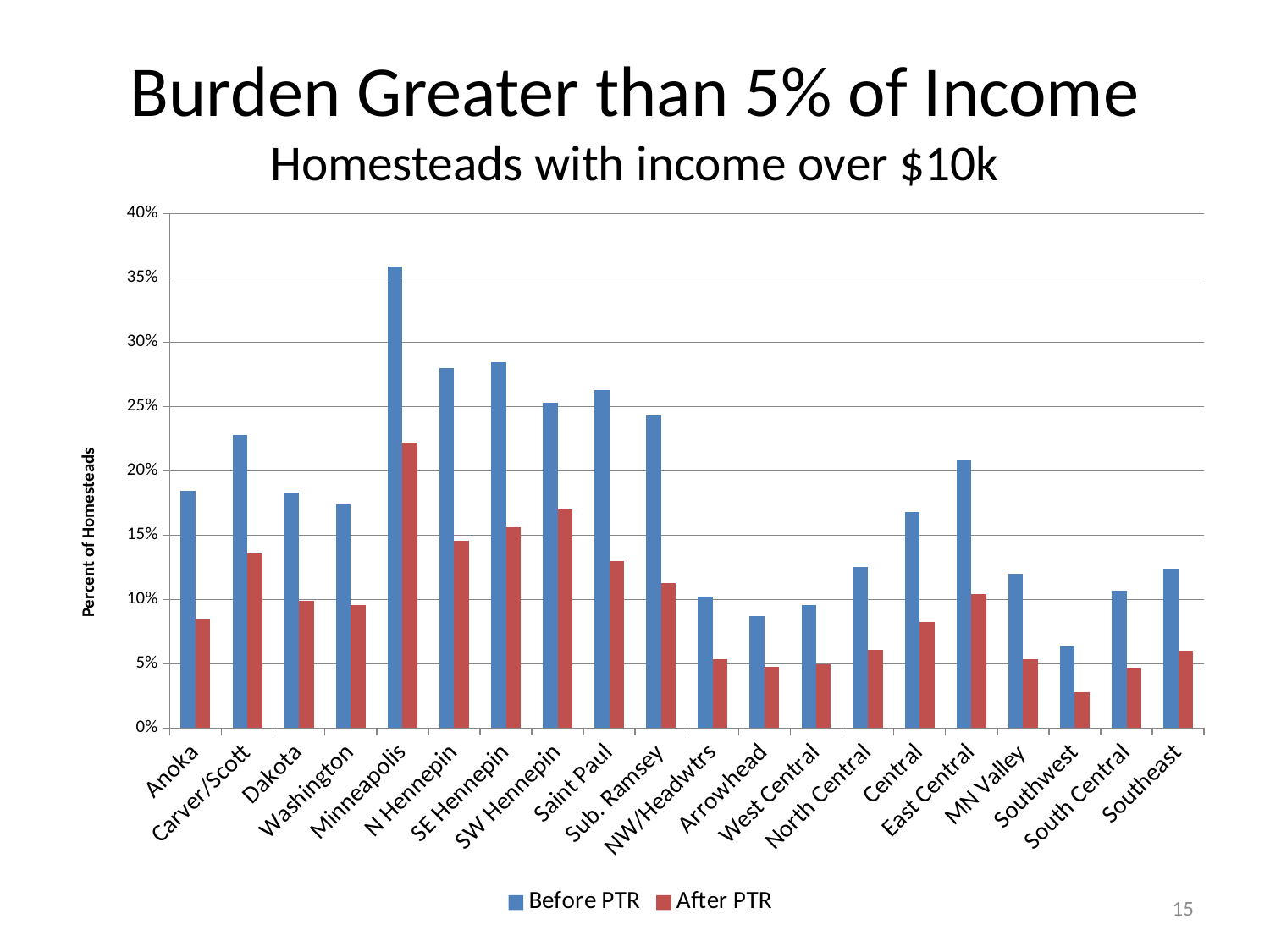
Is the After PTR value for Carver/Scott greater or less than 10%? greater Which region has the lowest Before PTR value? Southwest Which region has the highest After PTR value? Minneapolis How many series does the legend list? 2 Which region has the lowest After PTR value? Southwest What is the label on the y axis? Percent of Homesteads Is the Before PTR value for Minneapolis greater or less than 30%? greater What kind of chart is shown on the slide? bar chart Which is larger, the Before PTR value for Saint Paul or for Sub. Ramsey? Saint Paul Is the Before PTR value for Arrowhead greater or less than 10%? less Which region has the highest Before PTR value? Minneapolis How many regions are shown along the x axis? 20